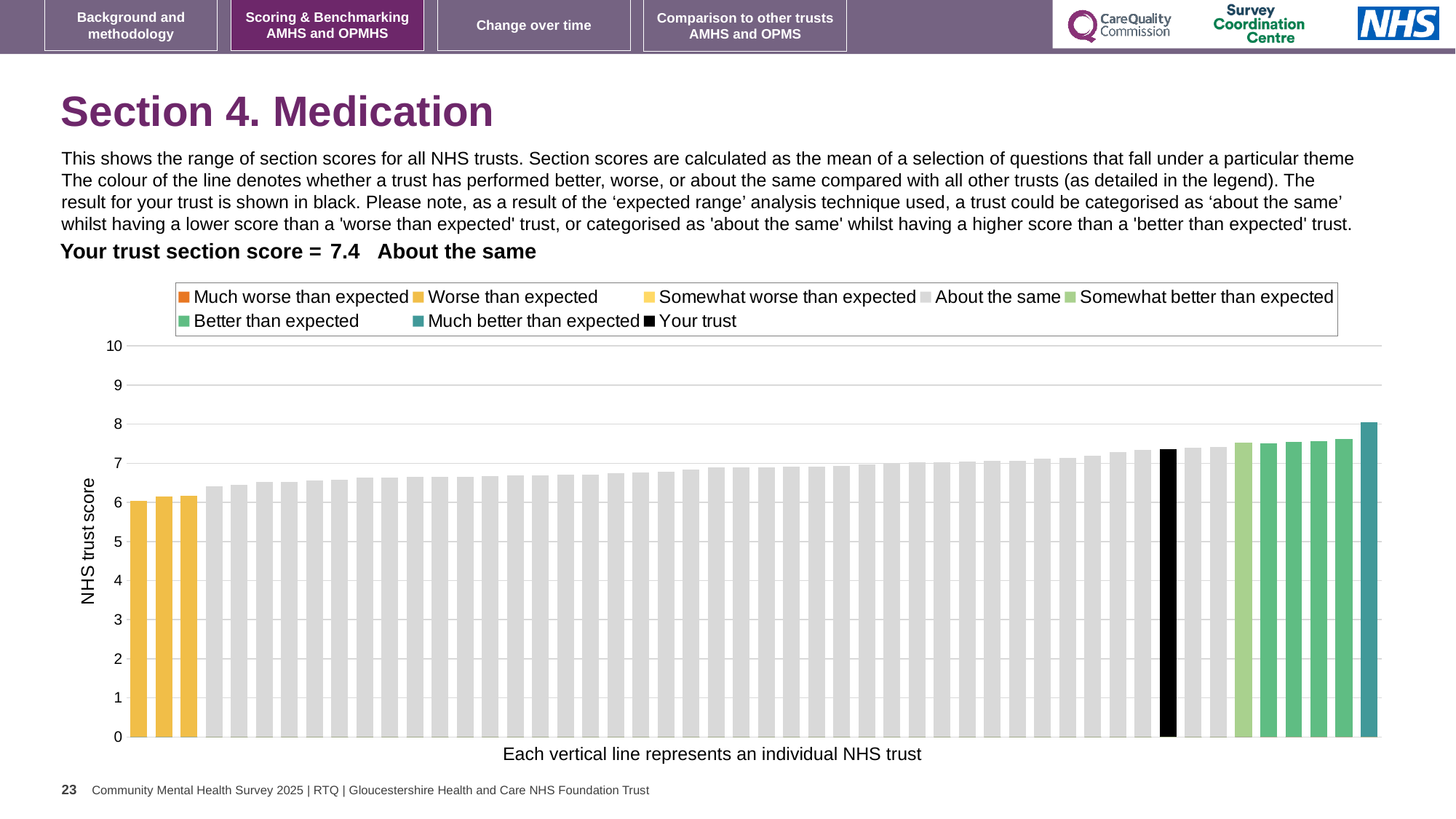
How many entries does the chart legend list? 8 What is the section score for your trust shown on the slide? 7.4 Do the bar values rise or fall from left to right across the chart? rise Is the value of the lowest bar in the chart greater or less than 5? greater How many bars are coloured as 'Worse than expected'? 3 Is the value of the highest bar in the chart greater or less than 9? less How many bars are coloured as 'Much better than expected'? 1 Which category is your trust's section score placed in? About the same What kind of chart is shown on the slide? bar chart What is the label on the vertical axis of the chart? NHS trust score Is the value of the black bar (Your trust) greater or less than 7? greater What colour is used for the 'Your trust' bar in the chart? black